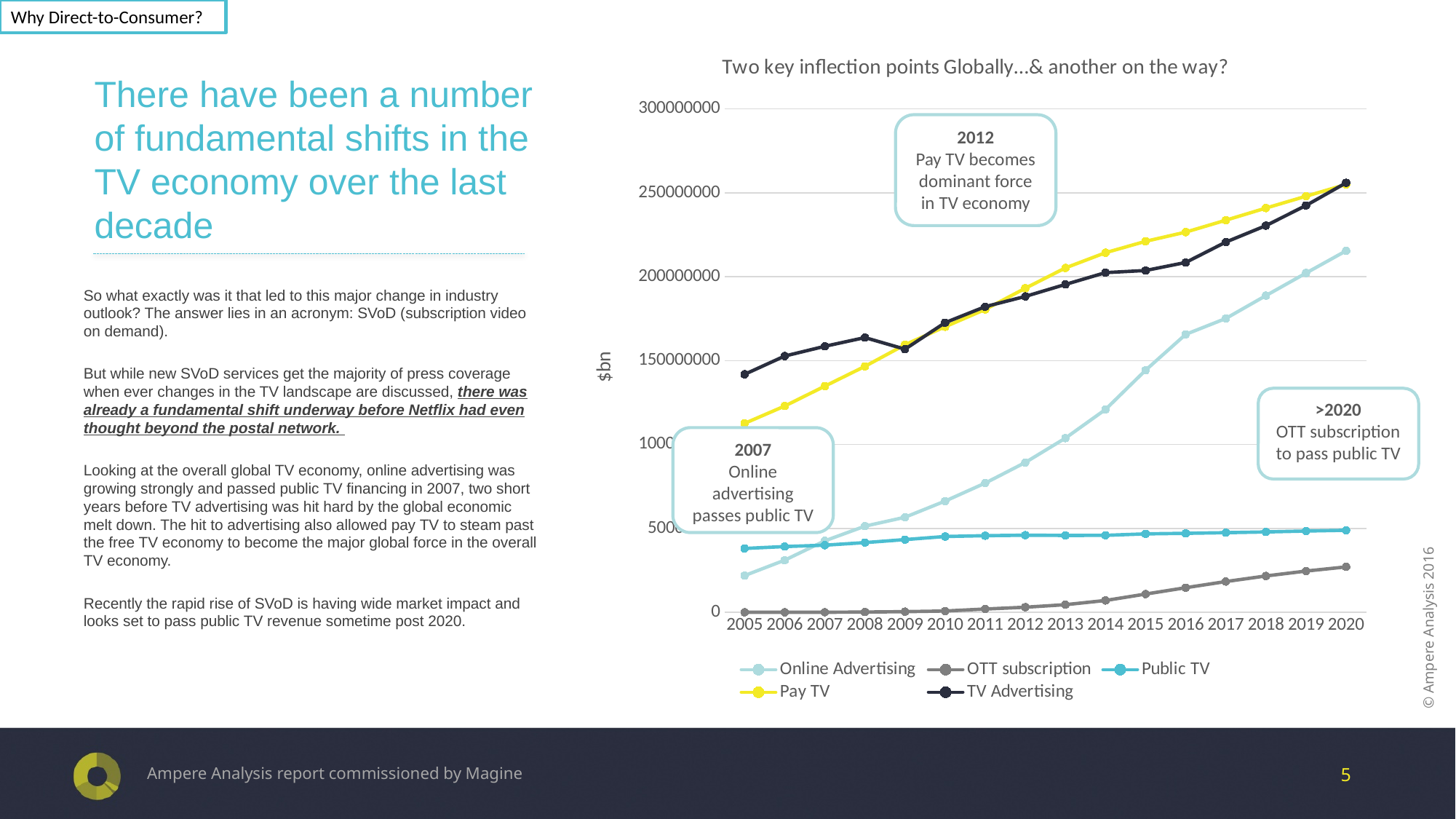
What label is shown on the y axis of the chart? $bn Which series has the lowest value in 2020? OTT subscription Is the value for OTT subscription in 2020 greater or less than 50000000? less Does the Online Advertising series rise or fall from 2005 to 2020? Rise In 2008, which is larger: TV Advertising or Pay TV? TV Advertising What kind of chart is shown on the slide? Line chart How many series does the chart legend list? 5 What is the title of the chart? Two key inflection points Globally…& another on the way? Is the value for Online Advertising in 2020 greater or less than 200000000? greater Which series has the highest value in 2005? TV Advertising In 2016, which is larger: Pay TV or TV Advertising? Pay TV How many years are plotted along the x axis of the chart? 16